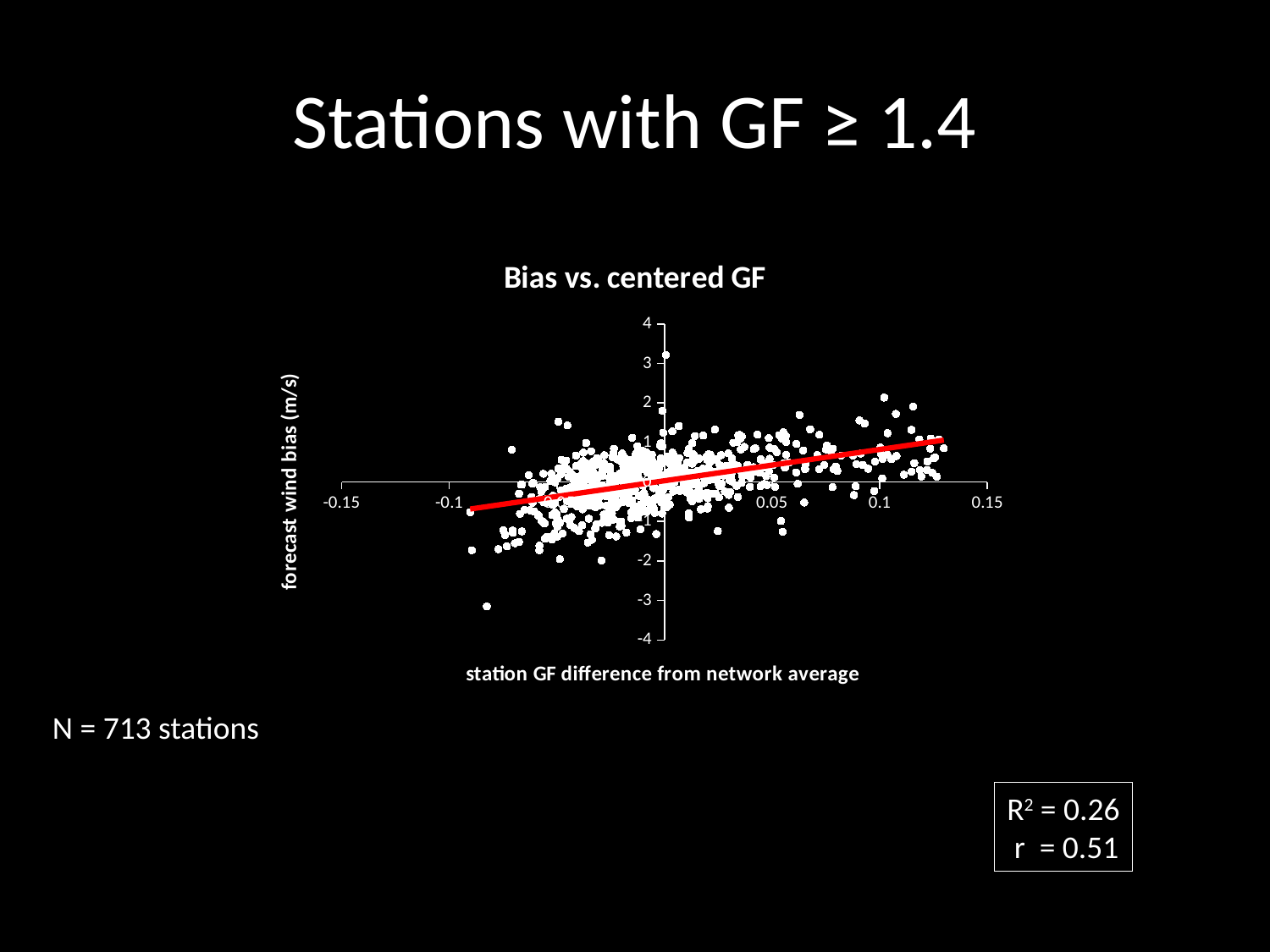
What is the title of the chart? Bias vs. centered GF What is the maximum value shown on the y axis? 4 How many stations are plotted in the chart? 713 What kind of chart is shown on the slide? Scatter plot Is the forecast wind bias at the right end of the red trend line (near x = 0.13) greater or less than 0? greater What is the minimum value shown on the x axis? -0.15 Is the highest plotted forecast wind bias value greater or less than 2? greater What is the R² value reported for the fit? 0.26 Does the red trend line rise or fall as the station GF difference from network average increases? Rises What is the label of the y axis? forecast wind bias (m/s) What is the correlation coefficient r reported on the slide? 0.51 Is the lowest plotted forecast wind bias value greater or less than -2? less